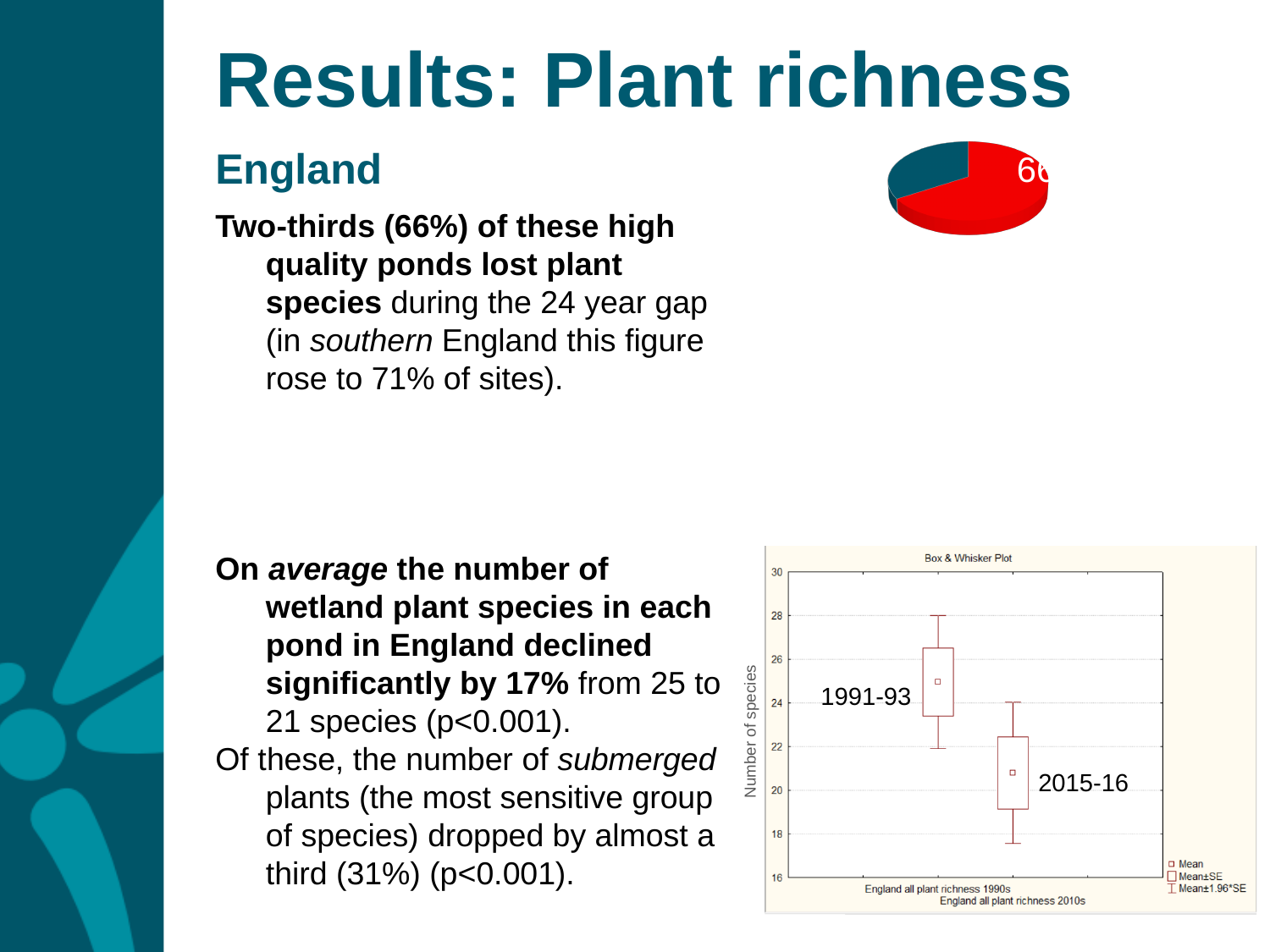
In the Box & Whisker Plot, is the mean number of species for 1991-93 greater or less than 24? greater In the Box & Whisker Plot, does the mean number of species rise or fall from 1991-93 to 2015-16? fall What is the title of the chart at the bottom right of the slide? Box & Whisker Plot In the Box & Whisker Plot, is the mean number of species for 2015-16 greater or less than 22? less In the pie chart at the top right, how many slices are there? 2 What kind of chart is shown at the top right of the slide? Pie chart In the Box & Whisker Plot, is the top of the whisker for 1991-93 greater or less than 26? greater In the Box & Whisker Plot, which period has the higher mean number of species, 1991-93 or 2015-16? 1991-93 What kind of chart is shown at the bottom right of the slide? Box and whisker plot What is the y-axis label of the Box & Whisker Plot? Number of species In the Box & Whisker Plot, how many entries does the legend list? 3 In the Box & Whisker Plot, how many groups (time periods) are plotted? 2